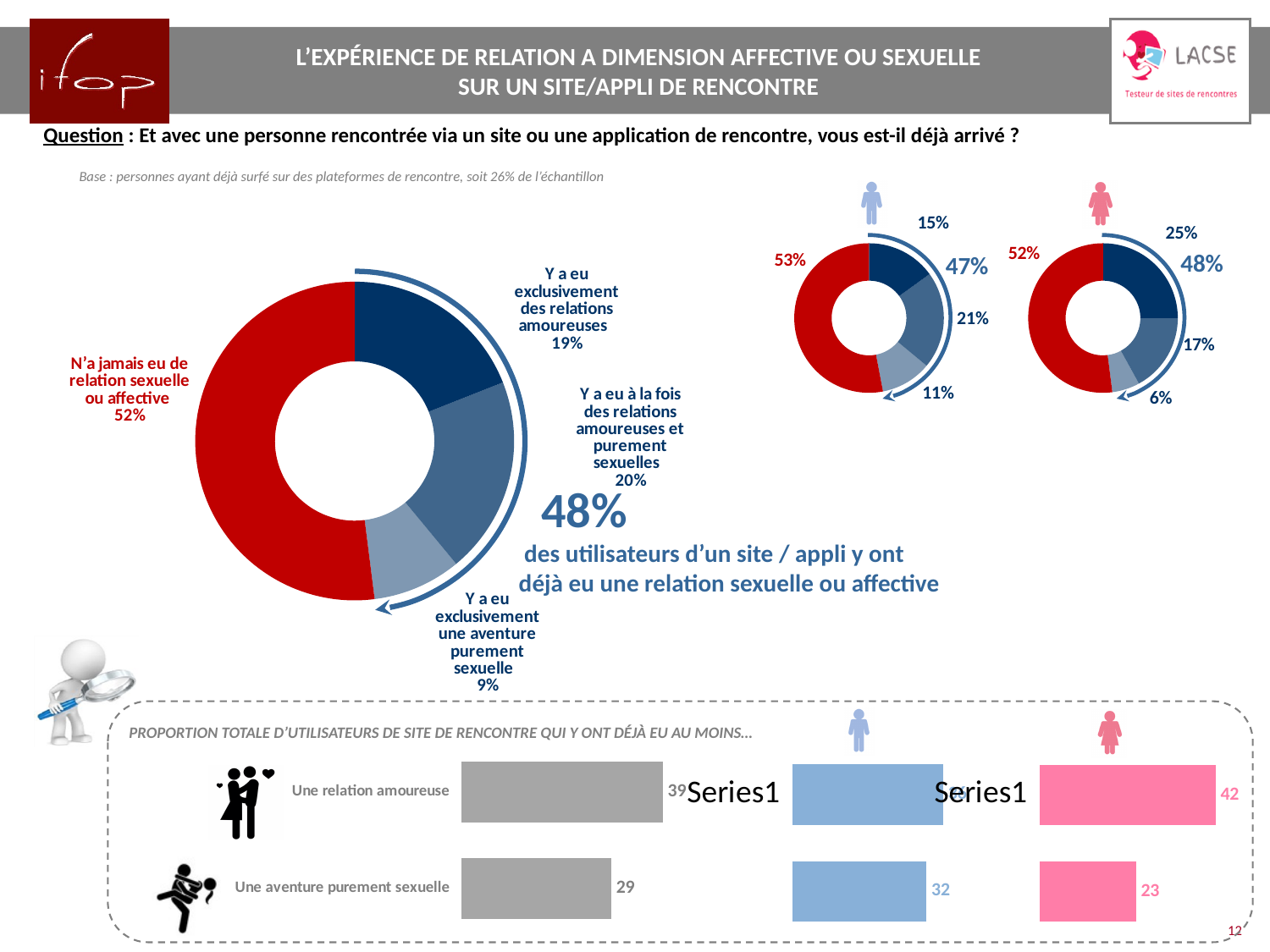
On the large donut chart, what percentage had exclusively romantic relationships (Y a eu exclusivement des relations amoureuses)? 19% On the small donut chart for women (pink figure), what percentage had exclusively a purely sexual adventure (smallest slice)? 6% What type of chart is the large chart on the left of the slide? Donut (pie) chart On the large donut chart, which category has the smallest share? Y a eu exclusivement une aventure purement sexuelle In the bottom bar chart for women (pink bars), what is the value for 'Une relation amoureuse'? 42 How many categories does the large donut chart show? 4 On the small donut chart for men (blue figure), what percentage have never had a sexual or affective relationship? 53% On the large donut chart, what is the difference between the share for 'Y a eu à la fois des relations amoureuses et purement sexuelles' and the share for 'Y a eu exclusivement une aventure purement sexuelle'? 11 percentage points In the bottom bar charts, is the value for 'Une aventure purement sexuelle' larger for men (blue bar, 32) or for women (pink bar, 23)? Men On the large donut chart, what percentage had exclusively a purely sexual adventure (Y a eu exclusivement une aventure purement sexuelle)? 9% On the large donut chart, what percentage of respondents have never had a sexual or affective relationship (N'a jamais eu de relation sexuelle ou affective)? 52% On the large donut chart, which category has the largest share? N'a jamais eu de relation sexuelle ou affective